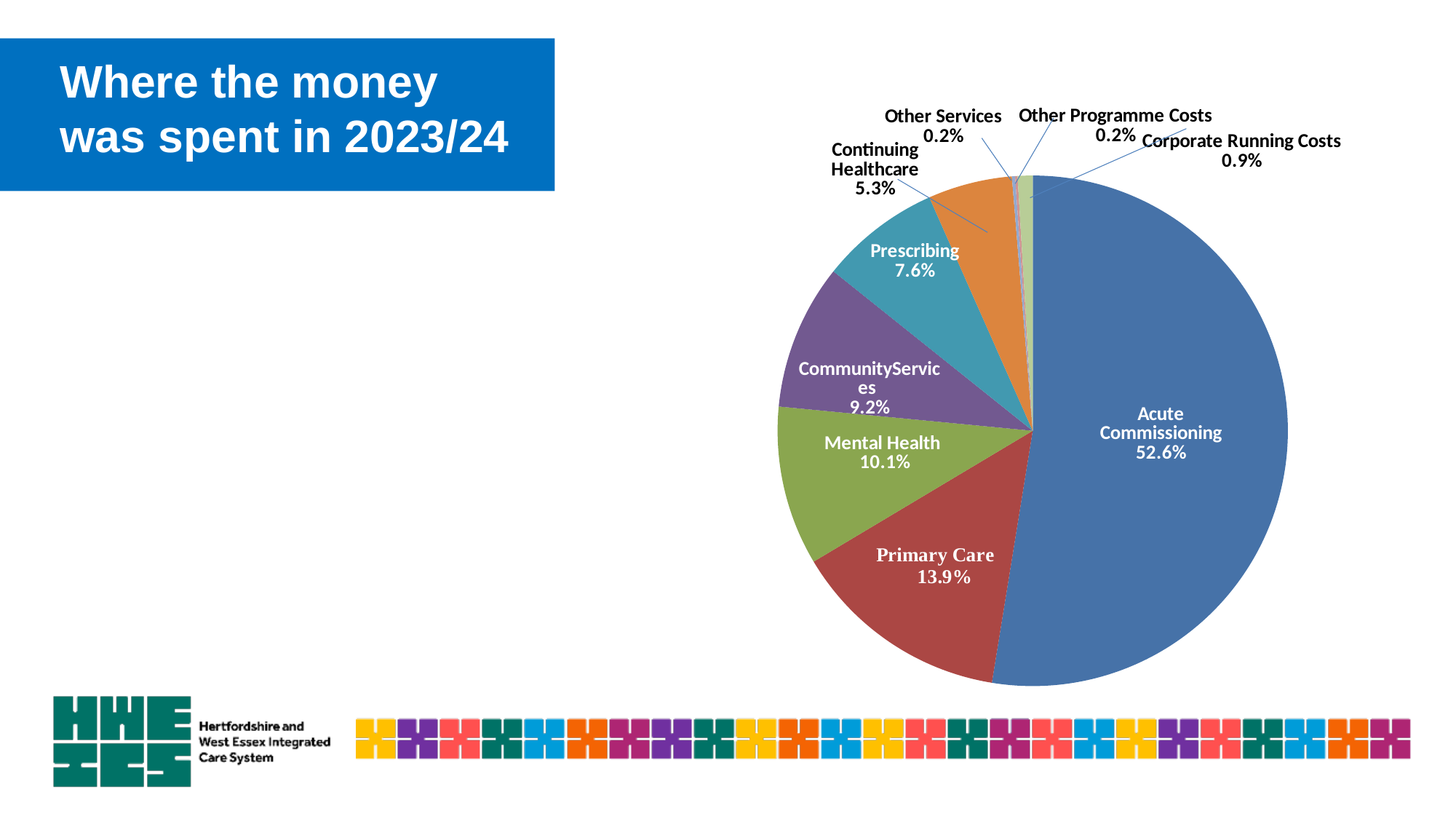
Which is larger, the share for Community Services or the share for Prescribing? Community Services What share of spending went to Prescribing? 7.6% What share of spending went to Primary Care? 13.9% How many slices does the pie chart have? 9 What share of spending went to Mental Health? 10.1% What share of spending went to Acute Commissioning? 52.6% Which category received the largest share of spending? Acute Commissioning What kind of chart is shown on the slide? Pie chart What is the title of the slide containing the chart? Where the money was spent in 2023/24 What is the difference in percentage points between Primary Care and Mental Health? 3.8 What share of spending went to Corporate Running Costs? 0.9% What share of spending went to Continuing Healthcare? 5.3%